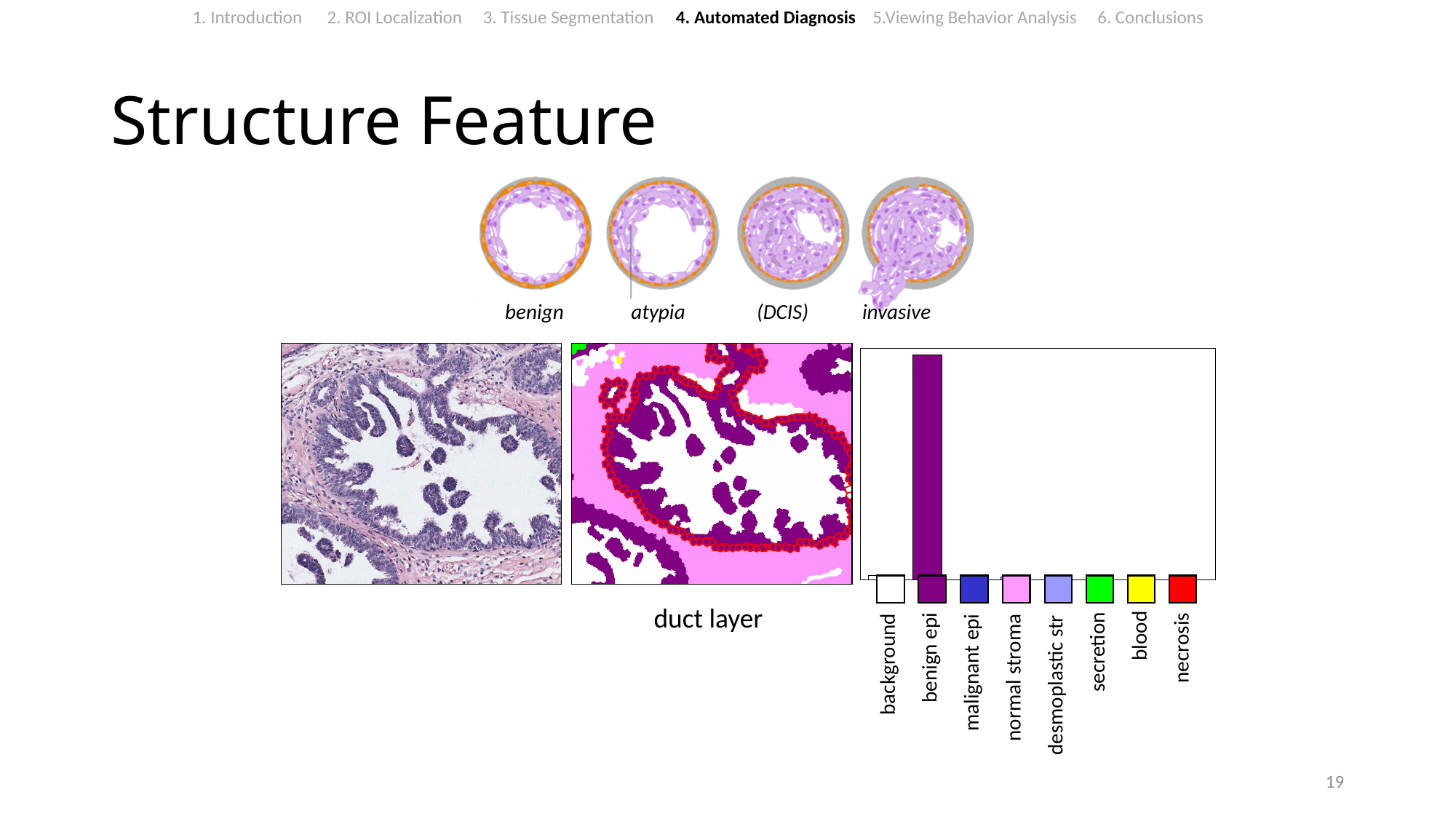
What is the first category listed on the x axis of the bar chart? background What is the last category listed on the x axis of the bar chart? necrosis How many categories are shown along the x axis of the bar chart? 8 What label appears beneath the segmentation image to the left of the bar chart? duct layer In the bar chart, which is larger, the bar for benign epi or the bar for malignant epi? benign epi Which category has the highest bar in the bar chart? benign epi In the bar chart, which is larger, the bar for benign epi or the bar for normal stroma? benign epi What kind of chart is shown on the right side of the slide? bar chart